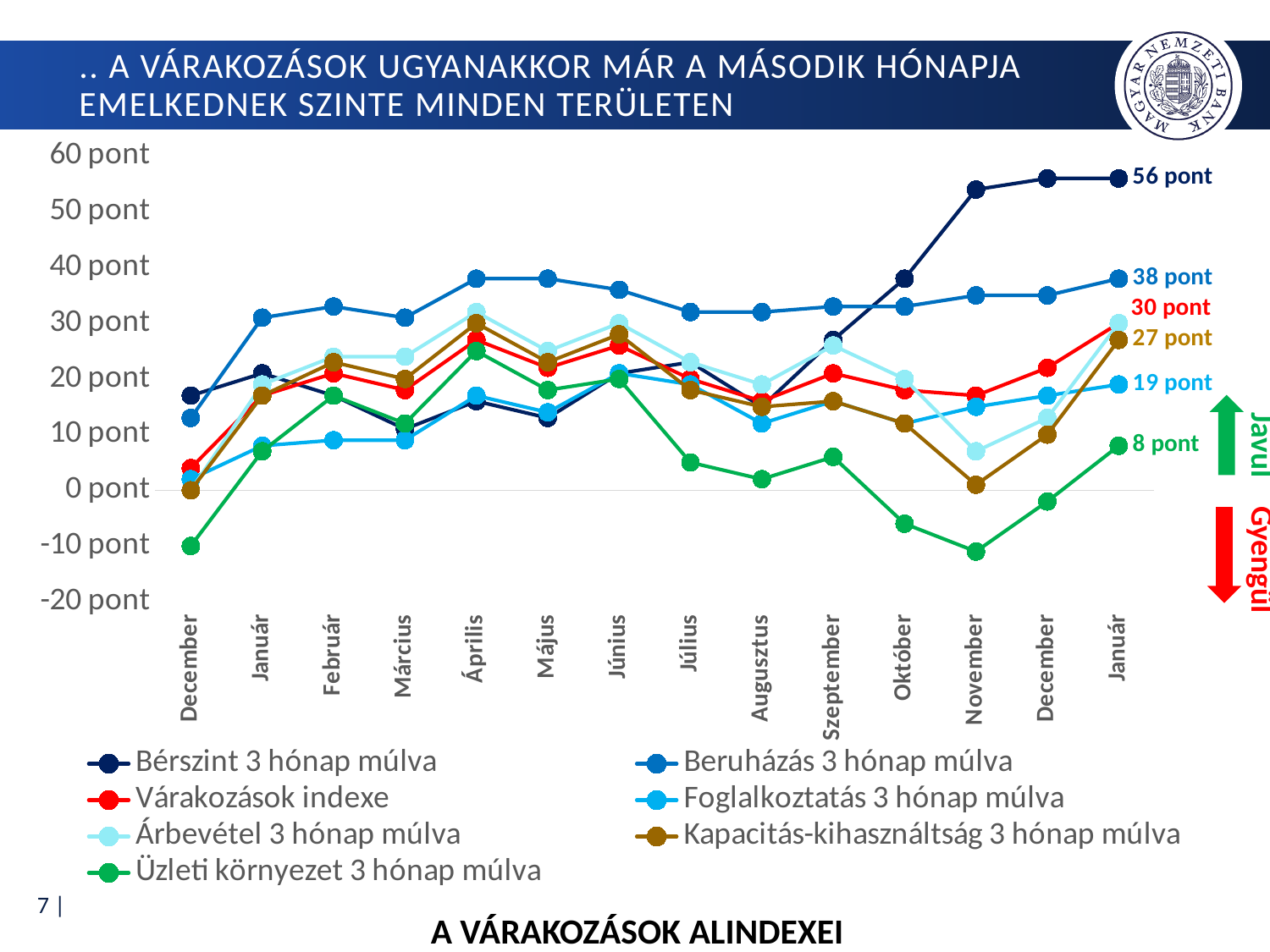
Is the value for Bérszint 3 hónap múlva in November greater or less than 50 pont? greater What is the value of Bérszint 3 hónap múlva at the final January point? 56 pont What is the value of Üzleti környezet 3 hónap múlva at the final January point? 8 pont What is the value of Foglalkoztatás 3 hónap múlva at the final January point? 19 pont What kind of chart is shown on the slide? line chart Which series has the lowest value at the final January point? Üzleti környezet 3 hónap múlva What is the difference between Bérszint 3 hónap múlva and Üzleti környezet 3 hónap múlva at the final January point? 48 pont How many months are shown along the x axis? 14 What is the value of Beruházás 3 hónap múlva at the final January point? 38 pont Which series has the highest value at the final January point? Bérszint 3 hónap múlva What is the title printed below the chart? A VÁRAKOZÁSOK ALINDEXEI How many series does the legend list? 7